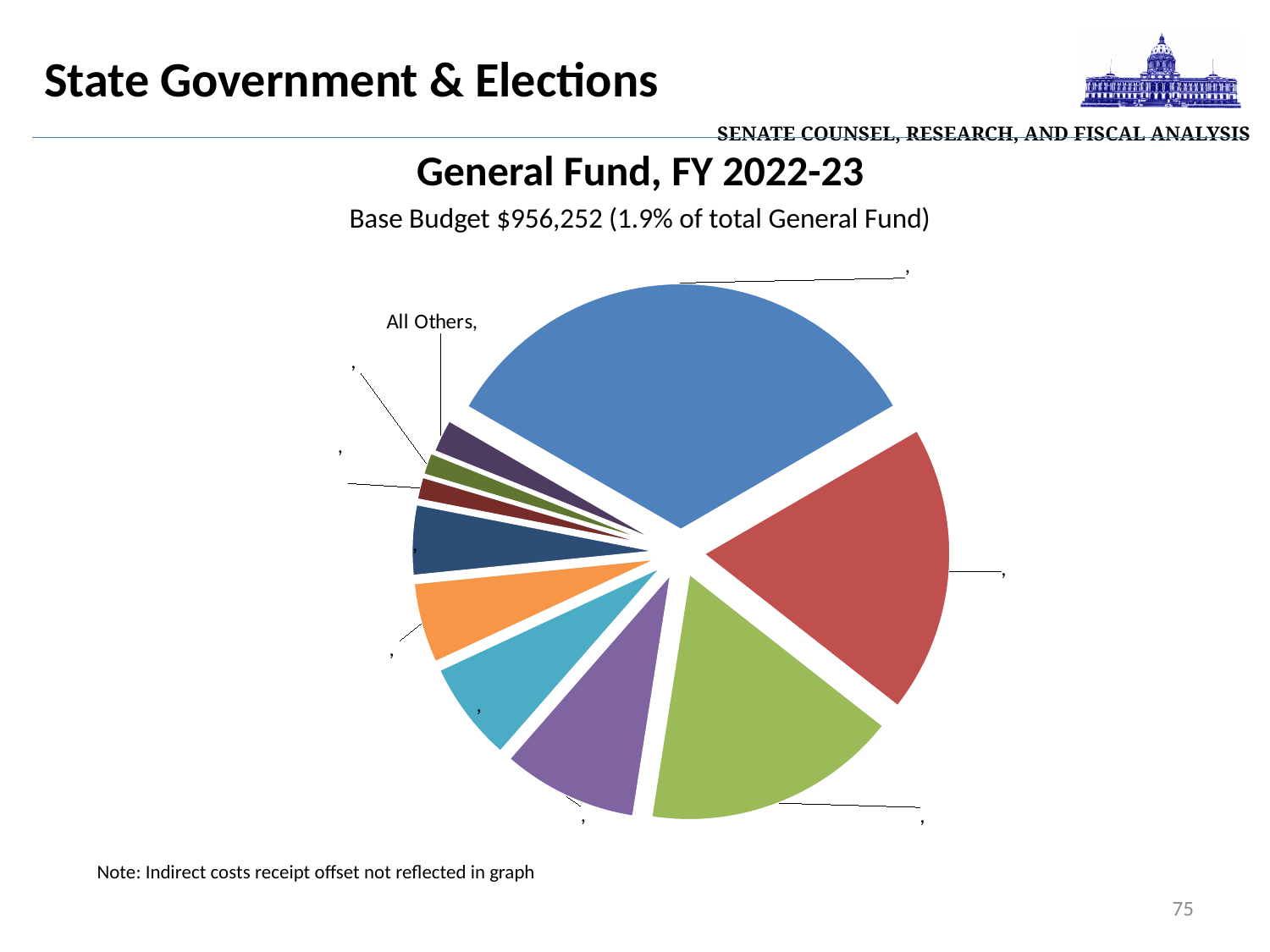
What is the title of the chart? General Fund, FY 2022-23 How many slices does the pie chart have? 10 What colour is the largest slice of the pie chart? blue Which is larger, the All Others slice or the red slice? the red slice What kind of chart is shown on the slide? pie chart